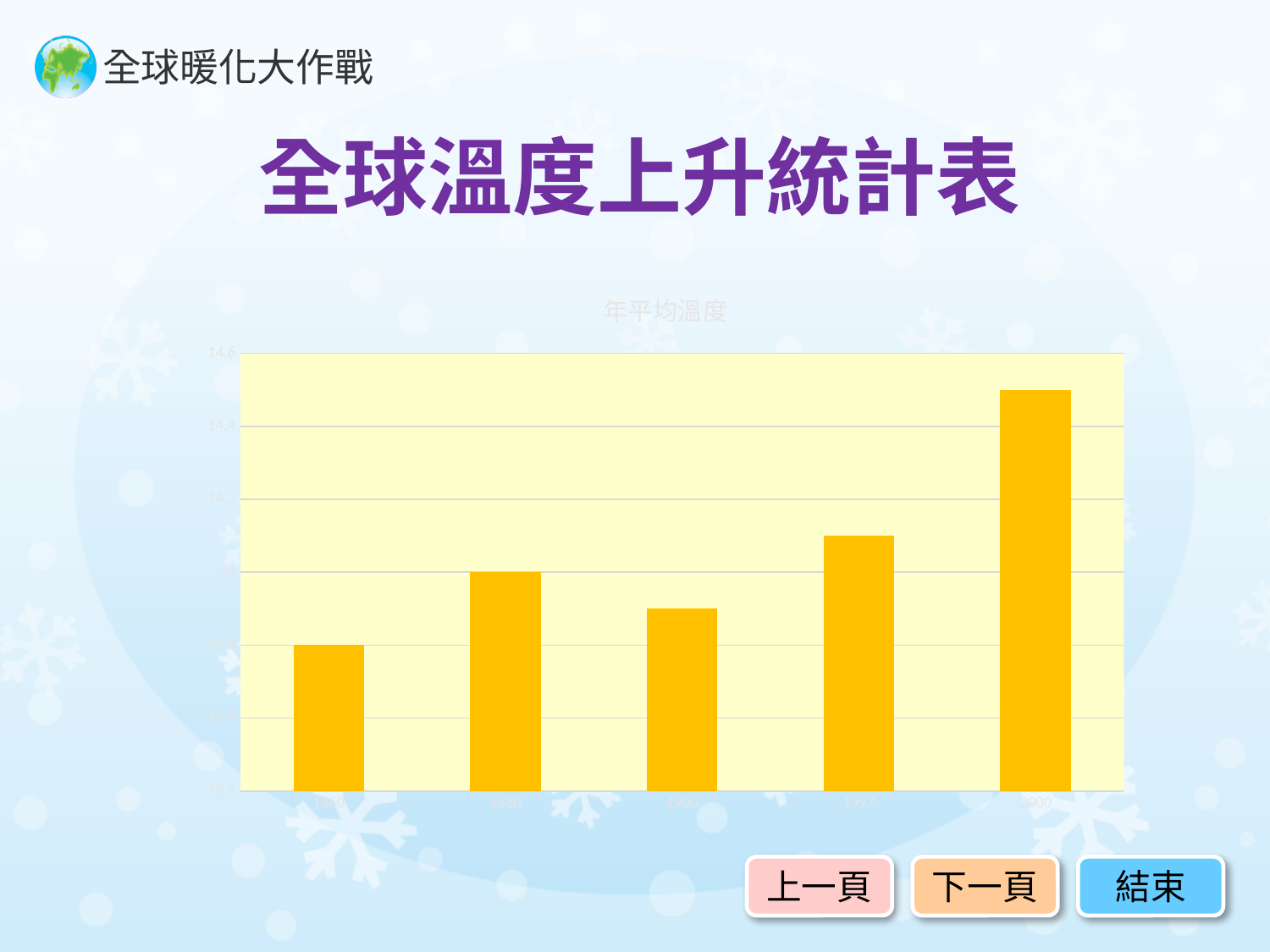
Which bar is the tallest in the chart? the rightmost bar (2000) What is the title printed above the chart? 年平均溫度 What colour are the bars in the chart? orange-yellow How many bars are plotted in the chart? 5 What kind of chart is shown on the slide? bar chart Is the value of the fourth bar from the left greater or less than 14.2? less Which is taller, the fourth bar from the left or the rightmost bar? the rightmost bar Is the value of the rightmost bar greater or less than 14.4? greater Which bar is the shortest in the chart? the leftmost bar Which is taller, the second bar from the left or the third bar from the left? the second bar Is the rightmost bar higher or lower than the leftmost bar? higher Is the value of the leftmost bar greater or less than 14.2? less